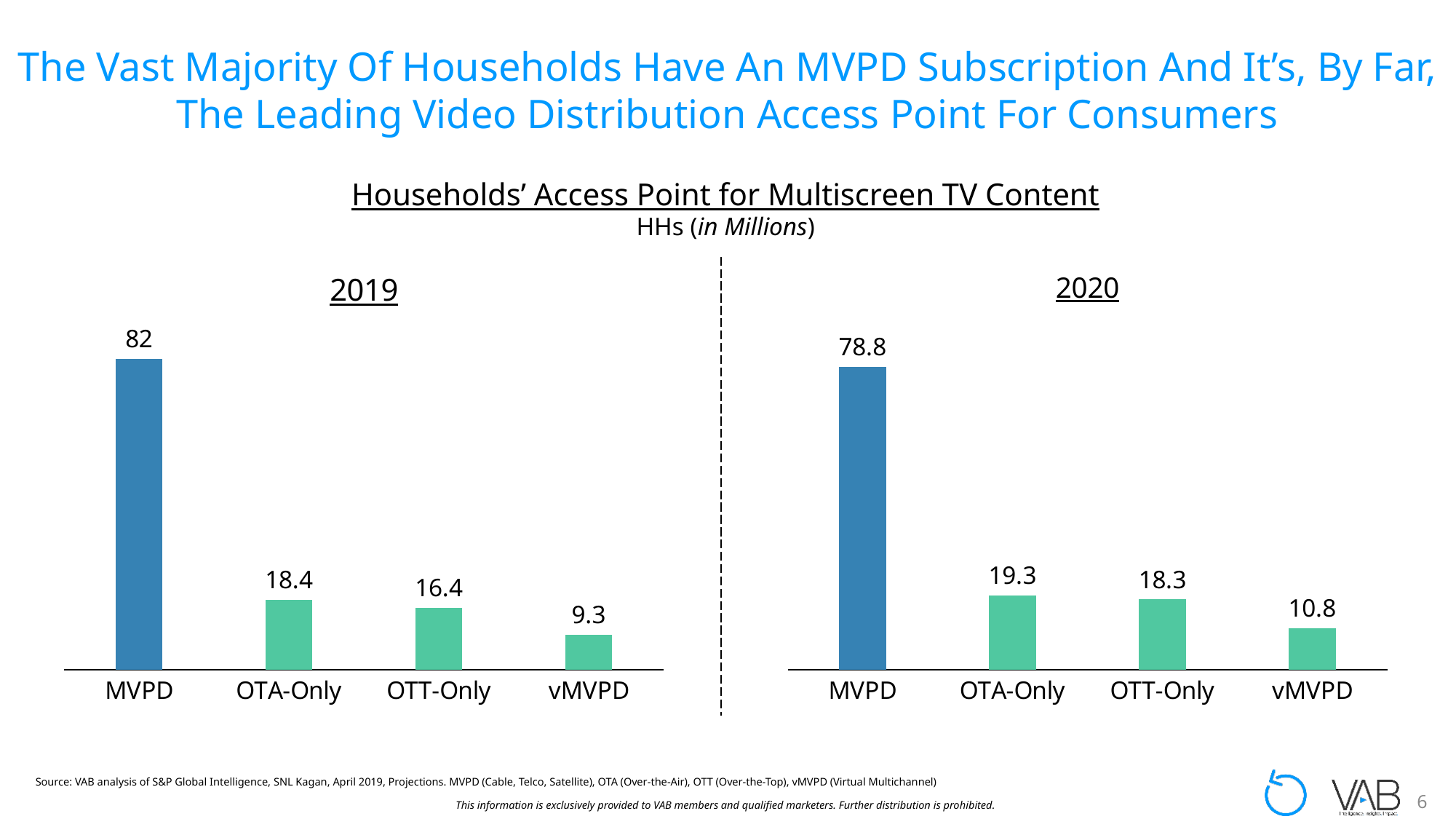
In the 2019 chart, what is the value for MVPD? 82 What type of chart is the 2019 chart? Bar chart In the 2020 chart, which category has the highest value? MVPD In the 2020 chart, what is the value for vMVPD? 10.8 In the 2019 chart, what is the difference between OTA-Only and vMVPD? 9.1 In the 2019 chart, what is the value for OTT-Only? 16.4 In the 2020 chart, what is the value for OTA-Only? 19.3 How many categories are shown in the 2020 chart? 4 What unit is stated under the chart title for the values shown? HHs (in Millions) Is the MVPD value larger in the 2019 chart or the 2020 chart? 2019 In the 2020 chart, what is the difference between the MVPD value and the OTT-Only value? 60.5 In the 2019 chart, which category has the lowest value? vMVPD